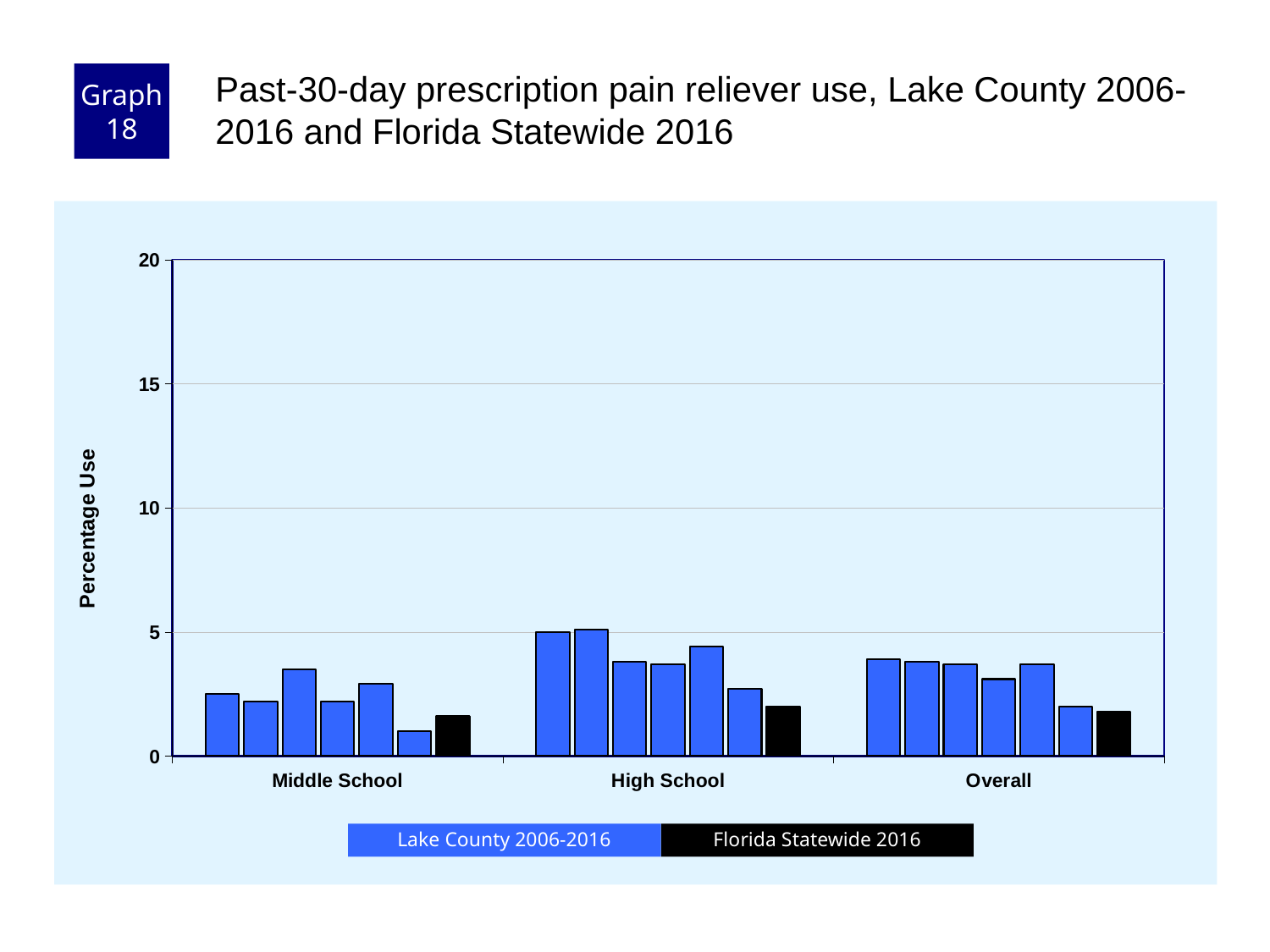
How many series does the legend list? 2 Is the value for Florida Statewide 2016 in the Middle School group greater or less than 5? less Is the Florida Statewide 2016 bar in the High School group greater or less than 5? less Which colour represents Florida Statewide 2016 in the legend? black Which category contains the shortest bar in the chart? Middle School How many categories are shown on the x axis? 3 What is the label on the y axis? Percentage Use Is the value for Florida Statewide 2016 in the Overall group greater or less than 5? less Which category contains the tallest bar in the chart? High School What kind of chart is shown on the slide? bar chart What is the highest value shown on the y axis? 20